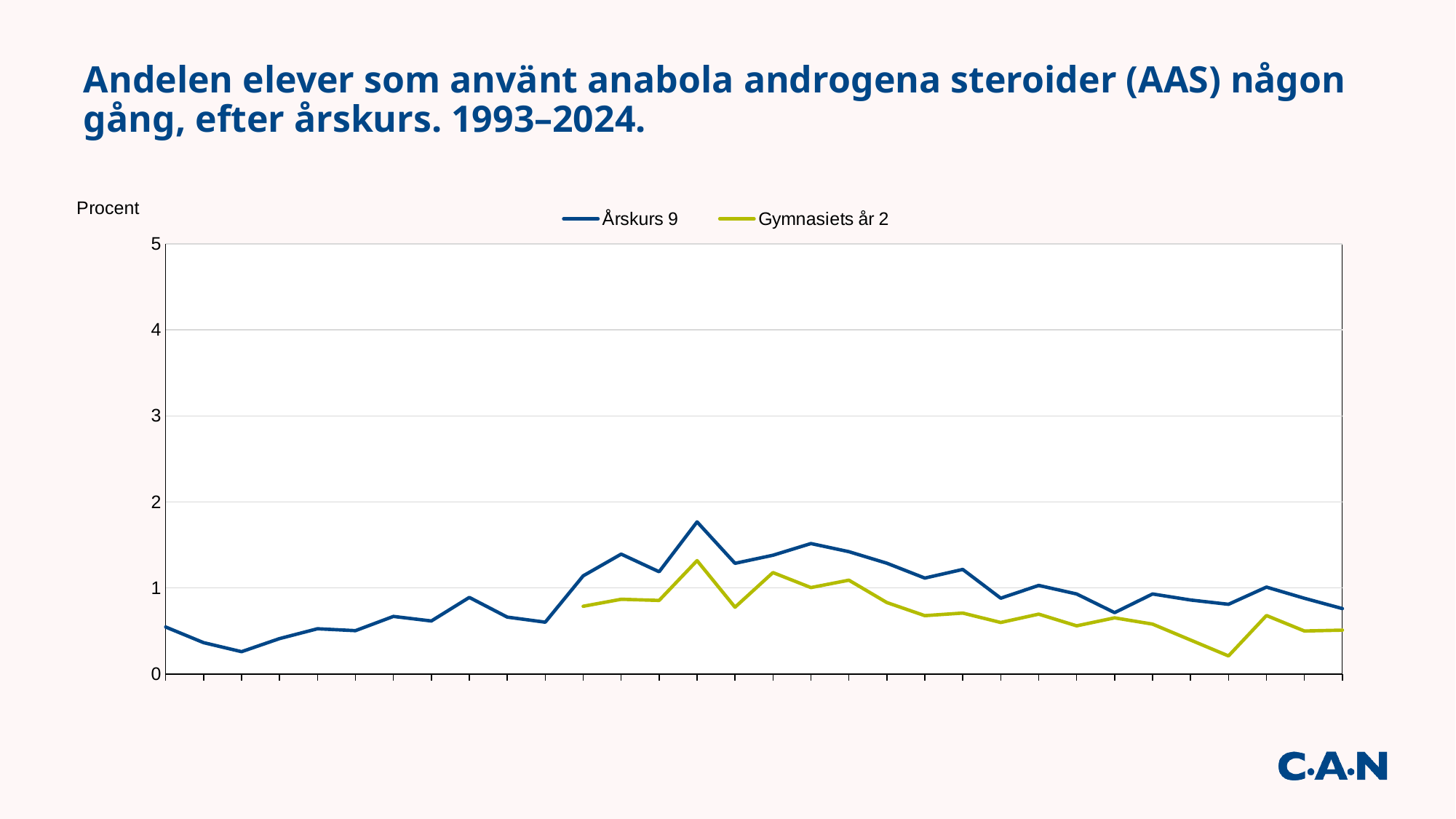
Is the highest value of the Årskurs 9 line greater or less than 2? less Which series lies lower for most of the period where both are plotted? Gymnasiets år 2 Is the lowest value of the Gymnasiets år 2 line greater or less than 0.5? less Is the value at the right end of the Årskurs 9 line greater or less than 1? less How many series does the legend list? 2 Does the Årskurs 9 line rise or fall from its peak to the right end of the chart? fall What kind of chart is shown on the slide? line chart What is the label on the vertical axis? Procent What is the highest value shown on the vertical axis? 5 Which series reaches the higher peak value, Årskurs 9 or Gymnasiets år 2? Årskurs 9